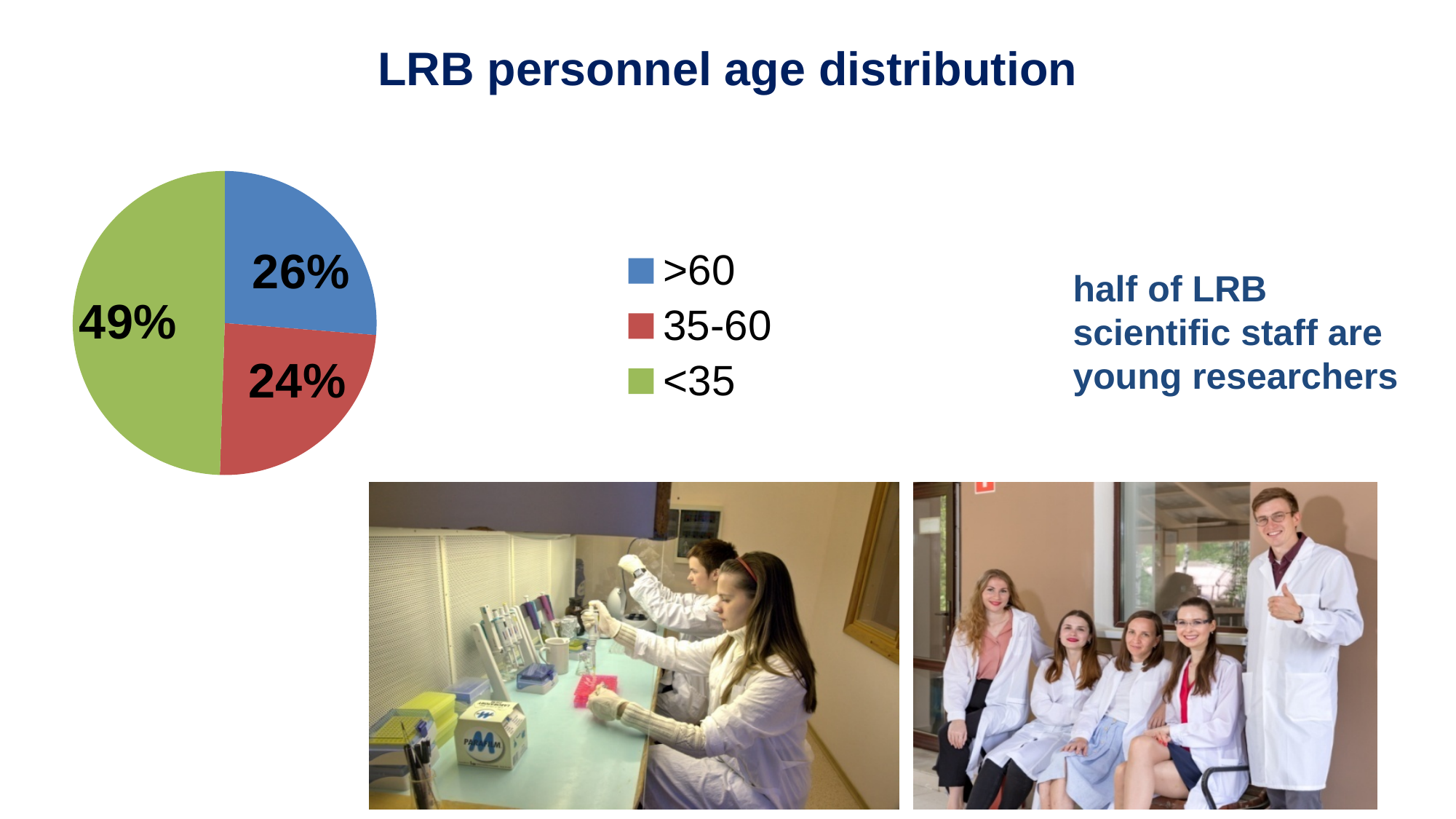
Which colour represents the <35 age group in the pie chart? green Which age group has the largest share of LRB personnel? <35 Which age group has the smallest share of LRB personnel? 35-60 What share of LRB personnel is in the 35-60 age group? 24% What type of chart is shown on the slide? pie chart What share of LRB personnel is in the >60 age group? 26% How many age groups are shown in the pie chart? 3 What is the title of the chart? LRB personnel age distribution Which age group has a larger share, <35 or 35-60? <35 What is the difference in percentage points between the <35 and >60 age groups? 23 What is the difference in percentage points between the >60 and 35-60 age groups? 2 What share of LRB personnel is in the <35 age group? 49%